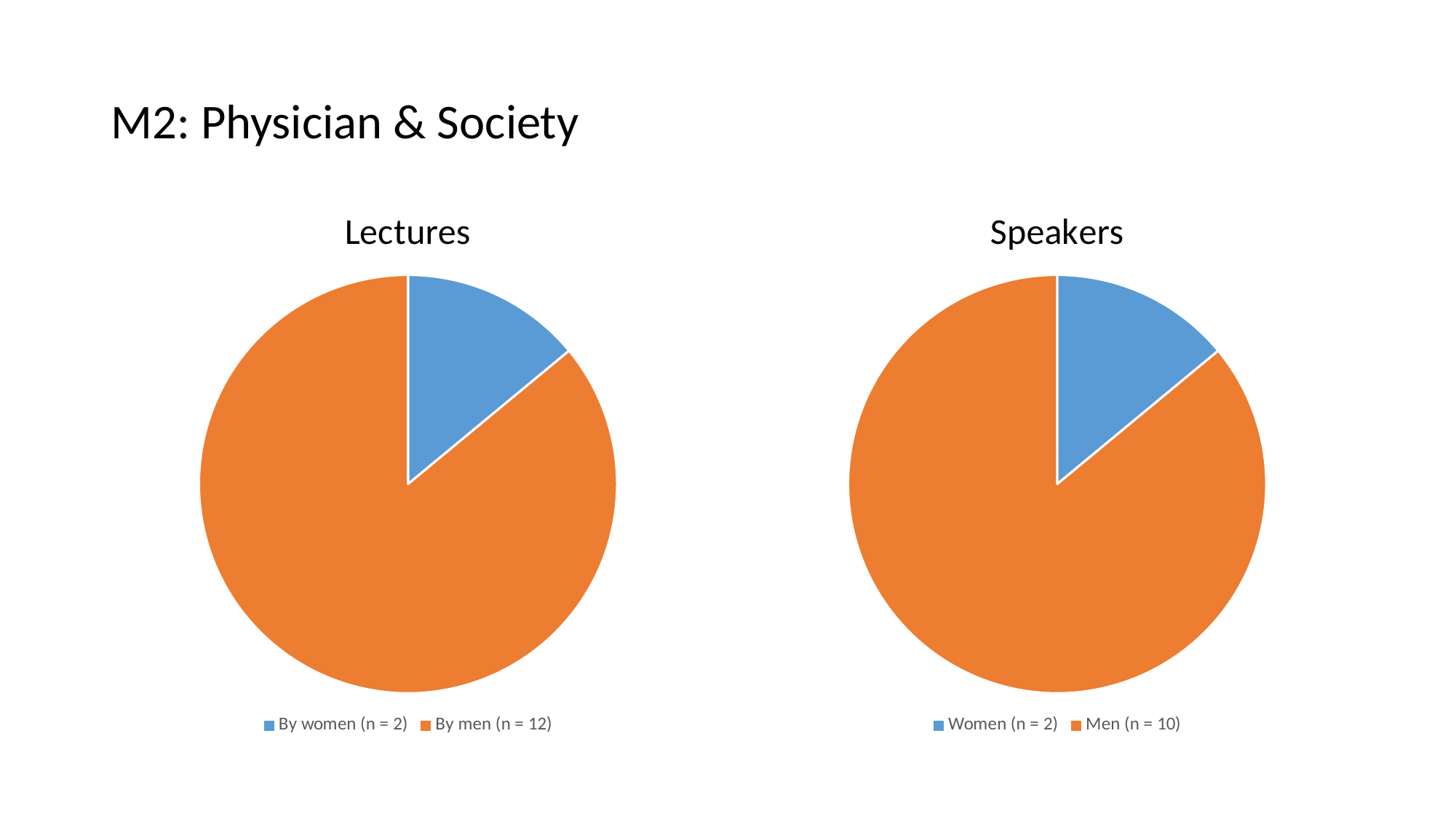
In the "Lectures" chart, how many lectures were given by men? 12 How many pie charts are shown on the slide? 2 In the "Lectures" chart, what colour is the slice for lectures by women? Blue In the "Speakers" chart, how many speakers were women? 2 In the "Lectures" chart, how many lectures were given by women? 2 What kind of chart is the "Lectures" chart? Pie chart In the "Speakers" chart, how many categories does the legend list? 2 In the "Speakers" chart, what is the difference between the number of men and women speakers? 8 In the "Speakers" chart, how many speakers were men? 10 In the "Lectures" chart, what is the difference between the number of lectures by men and by women? 10 In the "Speakers" chart, which category has the smallest slice? Women (n = 2) In the "Lectures" chart, which category has the largest slice? By men (n = 12)